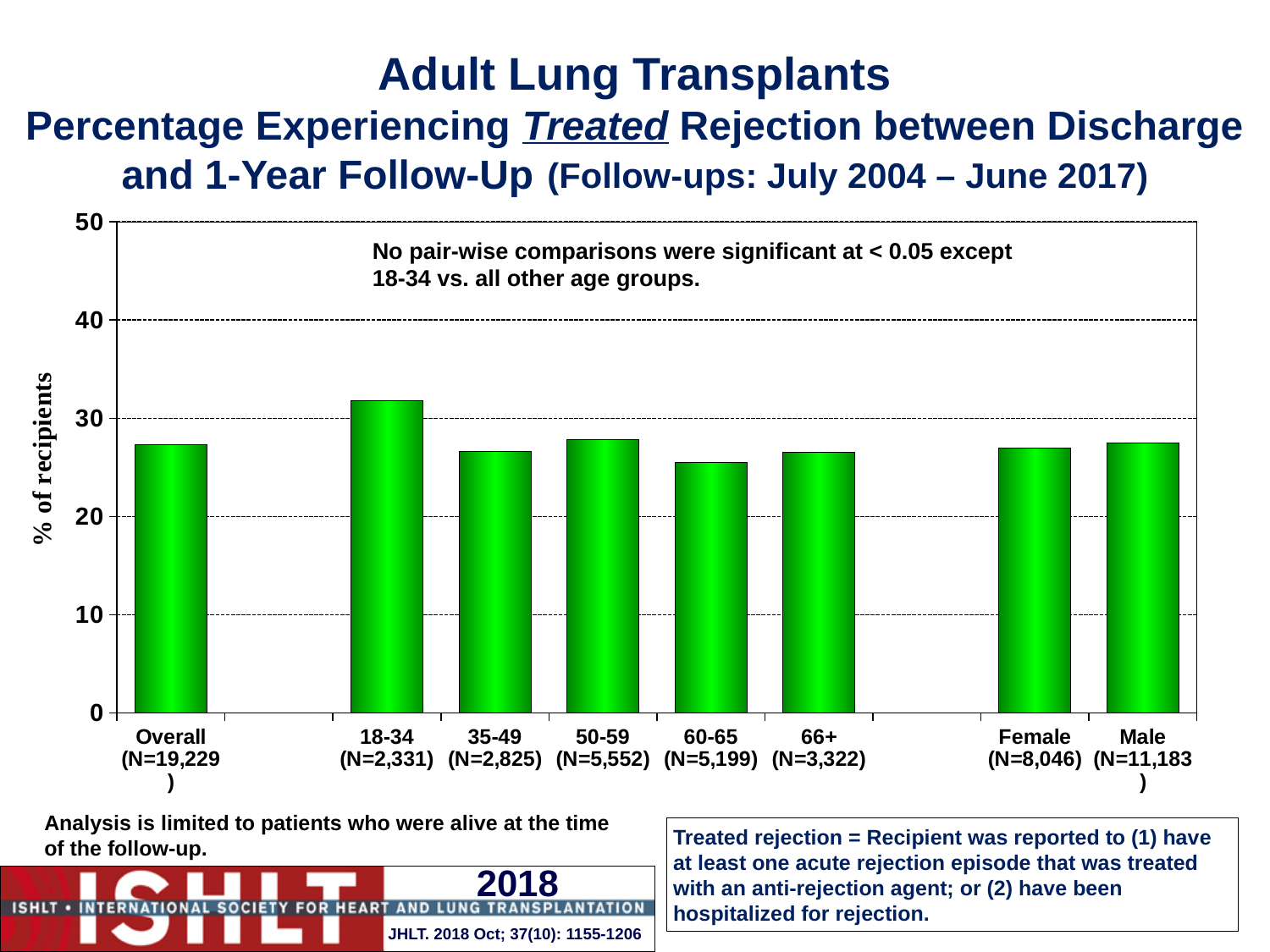
How many bars (categories) are plotted in the chart? 8 Is the value for Overall greater or less than 30? less Which is larger, the value for 18-34 or the value for 60-65? 18-34 What is the label of the y-axis? % of recipients Which is larger, the value for 18-34 or the value for 35-49? 18-34 Which category has the highest percentage of recipients experiencing treated rejection? 18-34 Is the value for Female greater or less than 40? less Is the value for the 18-34 age group greater or less than 30? greater What kind of chart is shown on the slide? bar chart What is the sample size (N) shown for the Male category? N=11,183